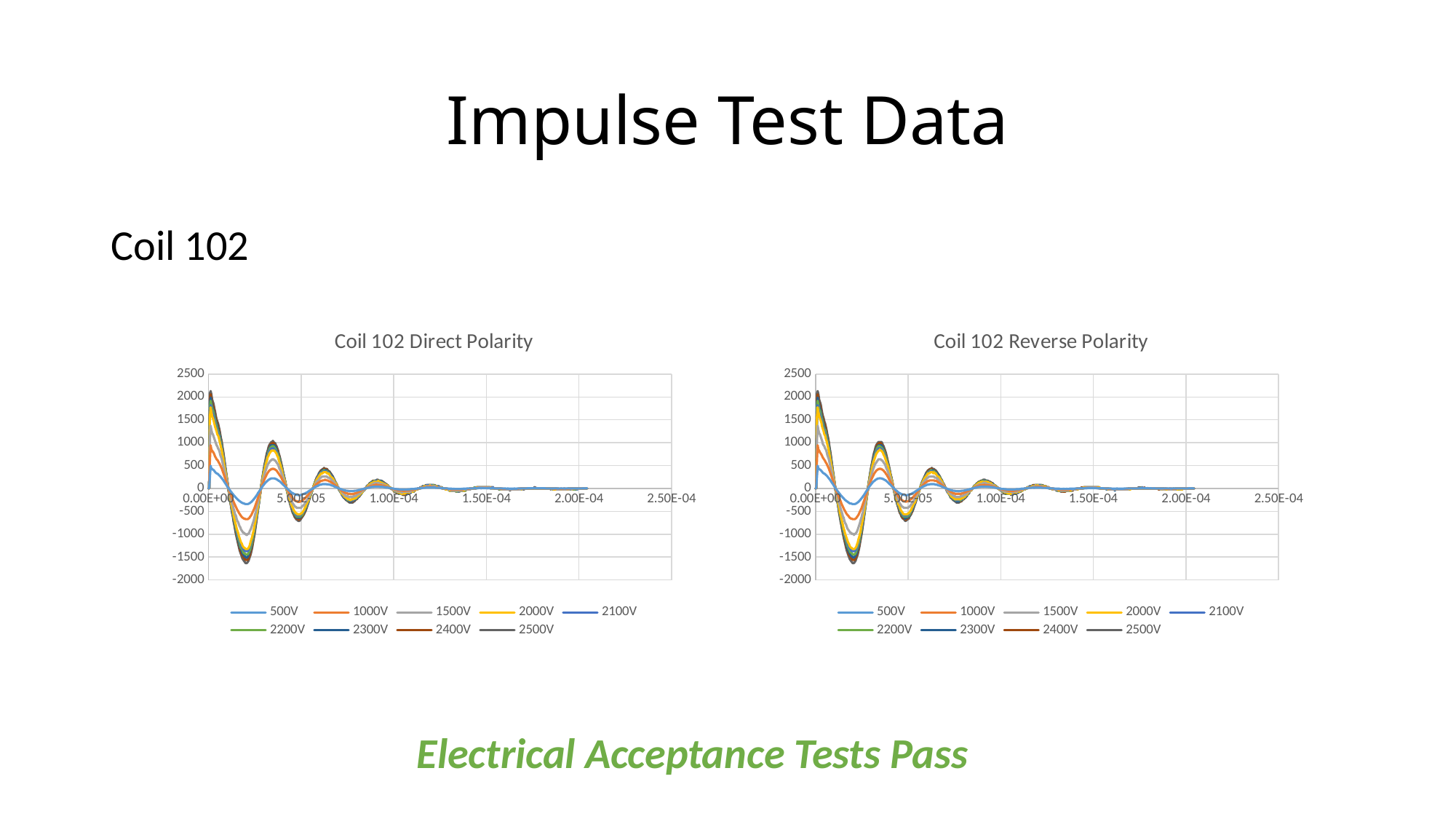
In the "Coil 102 Reverse Polarity" chart, which series has the smallest initial peak? 500V What kind of chart is the "Coil 102 Reverse Polarity" chart? line chart What is the title of the chart on the right of the slide? Coil 102 Reverse Polarity How many series does the legend of the "Coil 102 Direct Polarity" chart list? 9 How many series does the legend of the "Coil 102 Reverse Polarity" chart list? 9 In the "Coil 102 Direct Polarity" chart, does the amplitude of the oscillations rise or fall as time increases along the x axis? fall In the "Coil 102 Direct Polarity" chart, which series has the smallest initial peak? 500V What kind of chart is the "Coil 102 Direct Polarity" chart? line chart In the "Coil 102 Direct Polarity" chart, is the first trough of the 2500V series greater or less than -1000? less In the "Coil 102 Reverse Polarity" chart, is the initial peak of the 2500V series greater or less than 1500? greater In the "Coil 102 Direct Polarity" chart, is the initial peak of the 500V series greater or less than 1000? less What is the title of the chart on the left of the slide? Coil 102 Direct Polarity